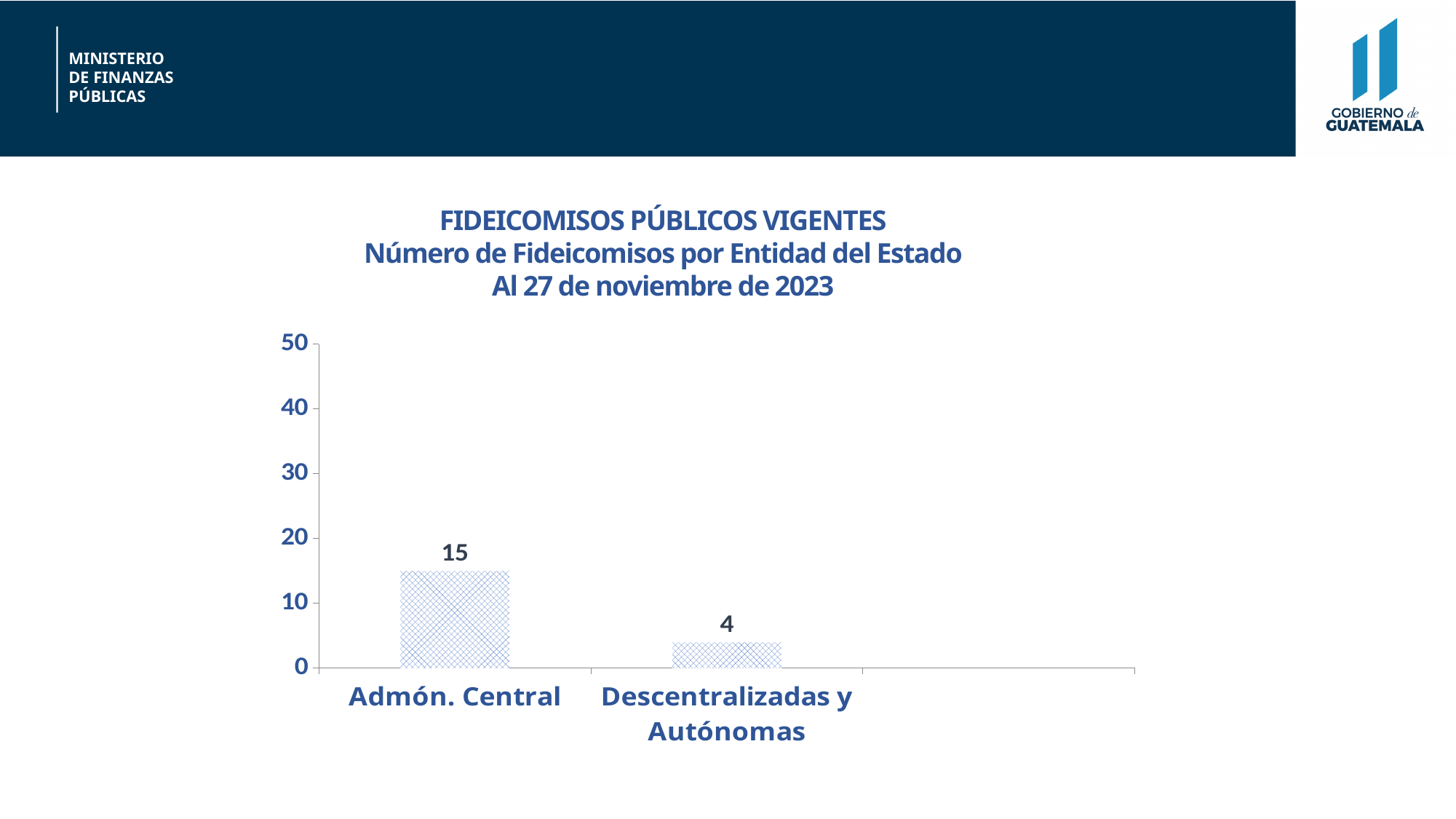
What kind of chart is shown on the slide? bar chart What is the total of the two bars shown? 19 Is the value for Descentralizadas y Autónomas greater or less than 10? less How many categories are shown on the x axis? 2 What is the value for Admón. Central? 15 What is the difference between the values for Admón. Central and Descentralizadas y Autónomas? 11 Which is larger, the value for Admón. Central or the value for Descentralizadas y Autónomas? Admón. Central What date is given in the chart title? 27 de noviembre de 2023 Which category has the lowest value? Descentralizadas y Autónomas Which category has the highest value? Admón. Central Is the value for Admón. Central greater or less than 20? less What is the value for Descentralizadas y Autónomas? 4